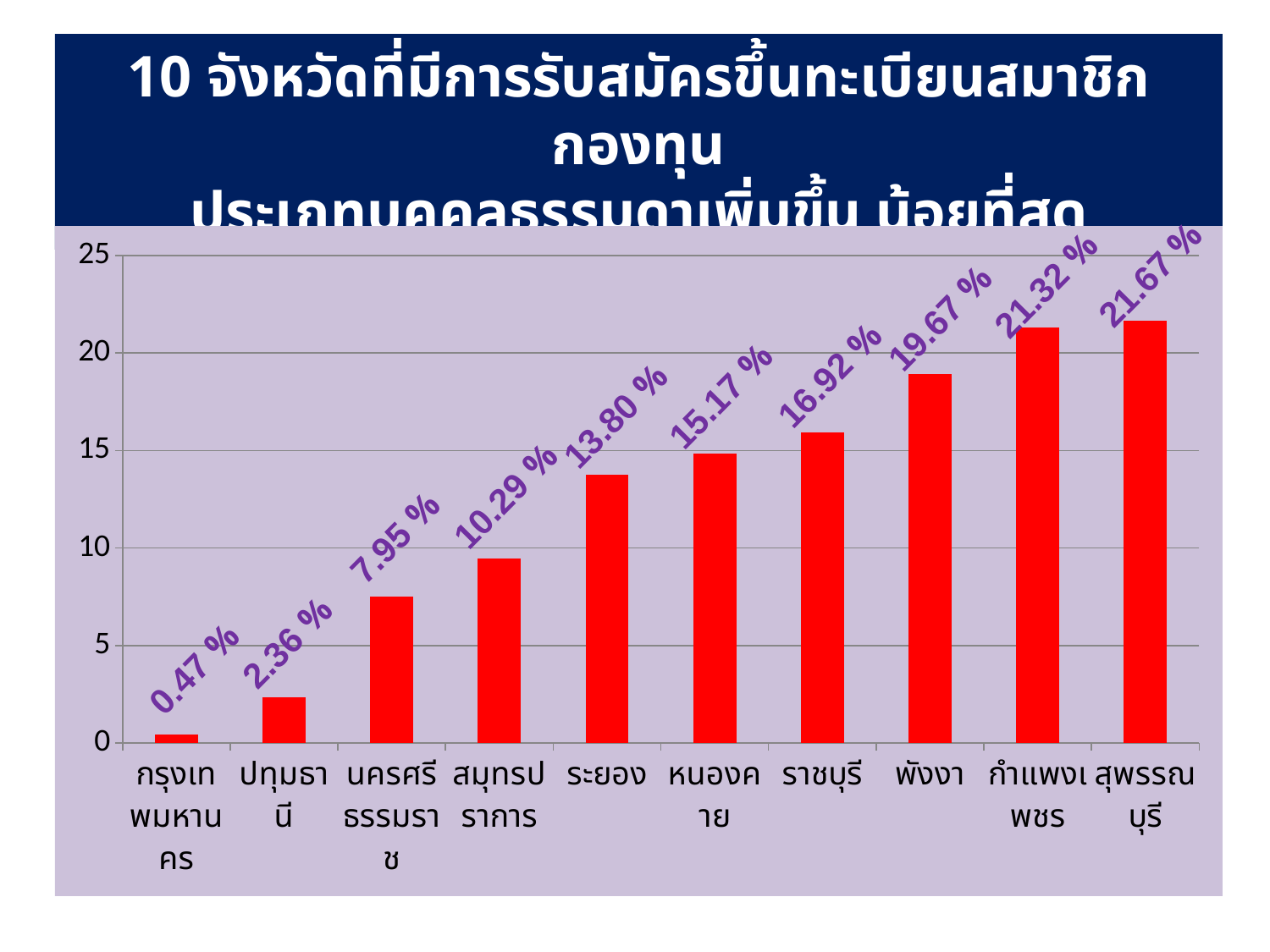
Is the value for กำแพงเพชร greater or less than 20? greater What is the value shown for กรุงเทพมหานคร? 0.47 % What is the value shown for ระยอง? 13.80 % What is the difference between the values for ราชบุรี and ปทุมธานี? 14.56 % What is the value shown for พังงา? 19.67 % How many provinces are shown in the chart? 10 What is the value shown for หนองคาย? 15.17 % What kind of chart is shown on the slide? bar chart Do the values rise or fall from left to right along the x axis? rise Which has a larger value, นครศรีธรรมราช or สมุทรปราการ? สมุทรปราการ Which province has the highest value? สุพรรณบุรี Which province has the lowest value? กรุงเทพมหานคร